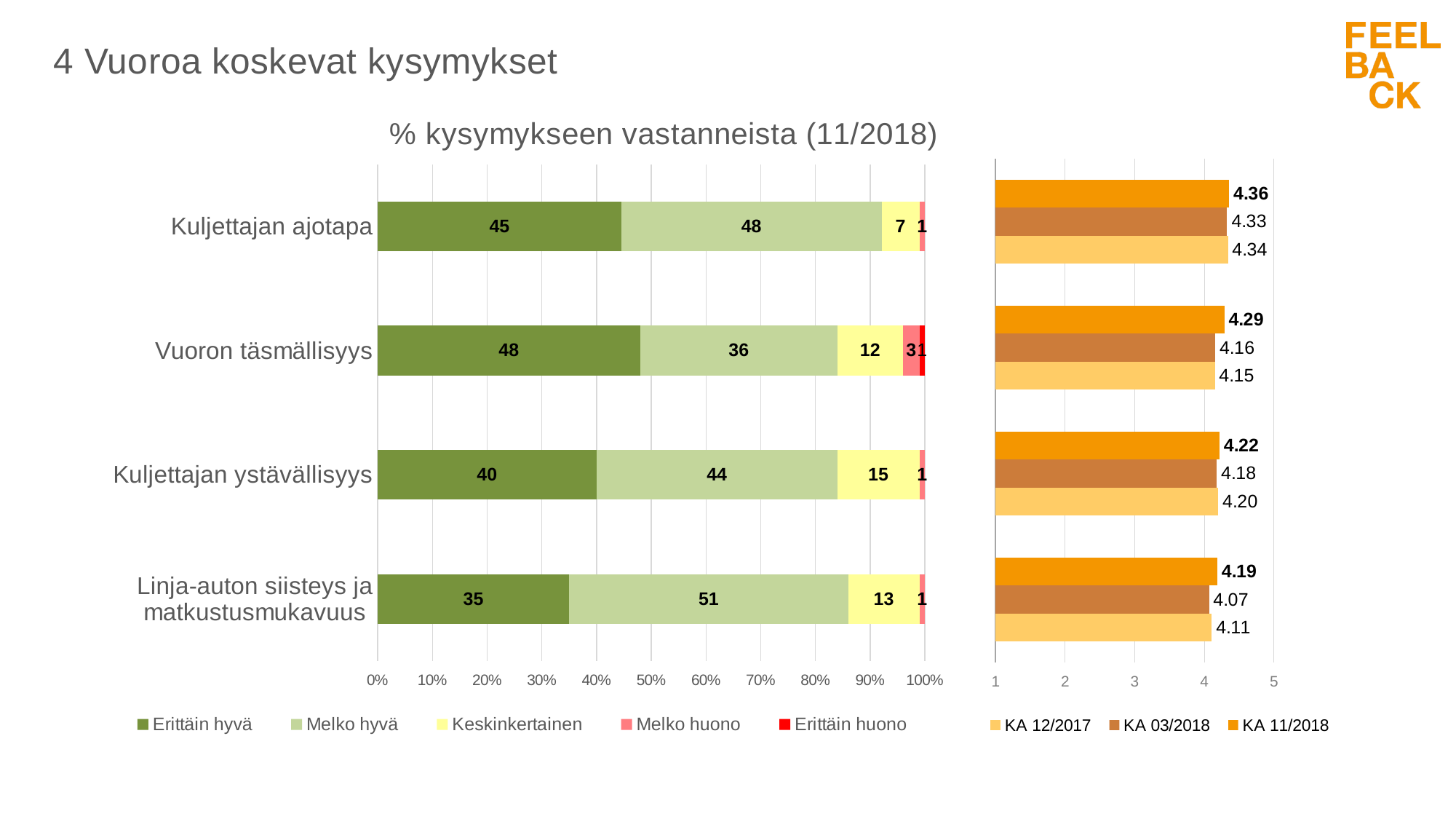
In the left chart '% kysymykseen vastanneista (11/2018)', how many series does the legend list? 5 In the right chart, which is larger for Kuljettajan ystävällisyys: KA 12/2017 or KA 03/2018? KA 12/2017 In the left chart '% kysymykseen vastanneista (11/2018)', which category has the lowest 'Keskinkertainen' value? Kuljettajan ajotapa In the right chart, what is the KA 11/2018 value for Vuoron täsmällisyys? 4.29 In the left chart '% kysymykseen vastanneista (11/2018)', which category has the highest 'Erittäin hyvä' value? Vuoron täsmällisyys In the left chart '% kysymykseen vastanneista (11/2018)', what is the difference between the 'Melko hyvä' values for Kuljettajan ajotapa and Vuoron täsmällisyys? 12 In the right chart, which category has the highest KA 11/2018 value? Kuljettajan ajotapa In the left chart '% kysymykseen vastanneista (11/2018)', what is the 'Melko hyvä' value for Linja-auton siisteys ja matkustusmukavuus? 51 In the left chart '% kysymykseen vastanneista (11/2018)', what kind of chart is it? Stacked bar chart In the right chart, how many series does the legend list? 3 In the right chart, what is the KA 03/2018 value for Linja-auton siisteys ja matkustusmukavuus? 4.07 In the left chart '% kysymykseen vastanneista (11/2018)', what is the 'Erittäin hyvä' value for Kuljettajan ajotapa? 45